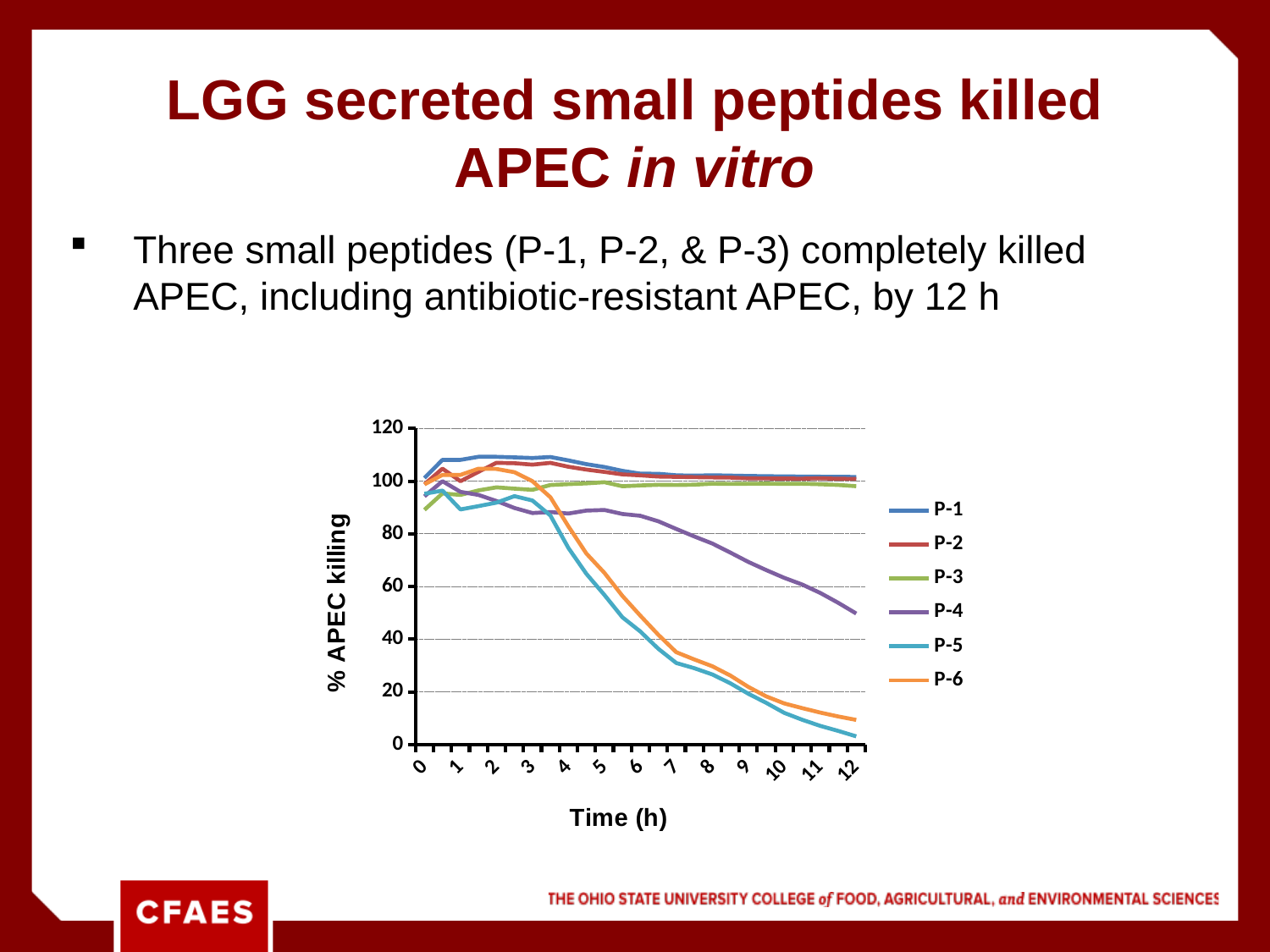
Is the value for P-6 at 8 h greater or less than 60? less Does the P-5 line rise or fall as time increases along the x axis? fall What is the title of the y axis? % APEC killing At 12 h, which is larger, the value for P-4 or the value for P-6? P-4 Is the value for P-1 at 6 h greater or less than 80? greater Does the P-4 line rise or fall from 5 h to 12 h? fall What kind of chart is shown on the slide? line chart How many series does the legend list? 6 Is the value for P-4 at 12 h greater or less than 40? greater How many time points are marked on the x axis? 13 Which series has the lowest value at 12 h? P-5